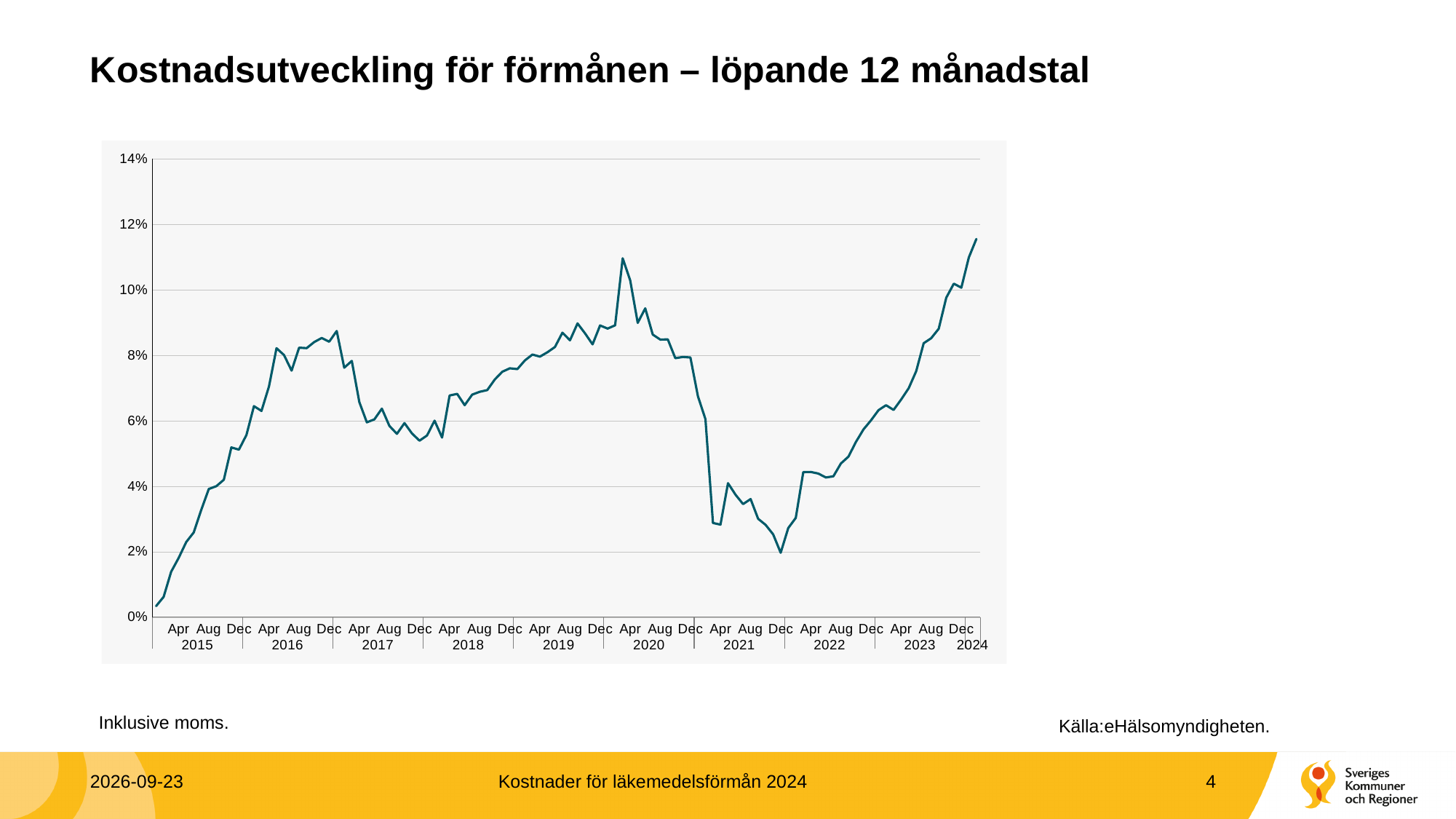
Is the value for Apr 2015 greater or less than 4%? less What kind of chart is shown on the slide? line chart Is the value for Dec 2021 greater or less than 4%? less Does the line rise or fall from Dec 2021 to the end of the series in 2024? rise Is the value for Aug 2022 greater or less than 6%? less What is the title of the chart on the slide? Kostnadsutveckling för förmånen – löpande 12 månadstal What is the highest value shown on the y axis? 14% Does the line rise or fall from Apr 2020 to Dec 2021? fall